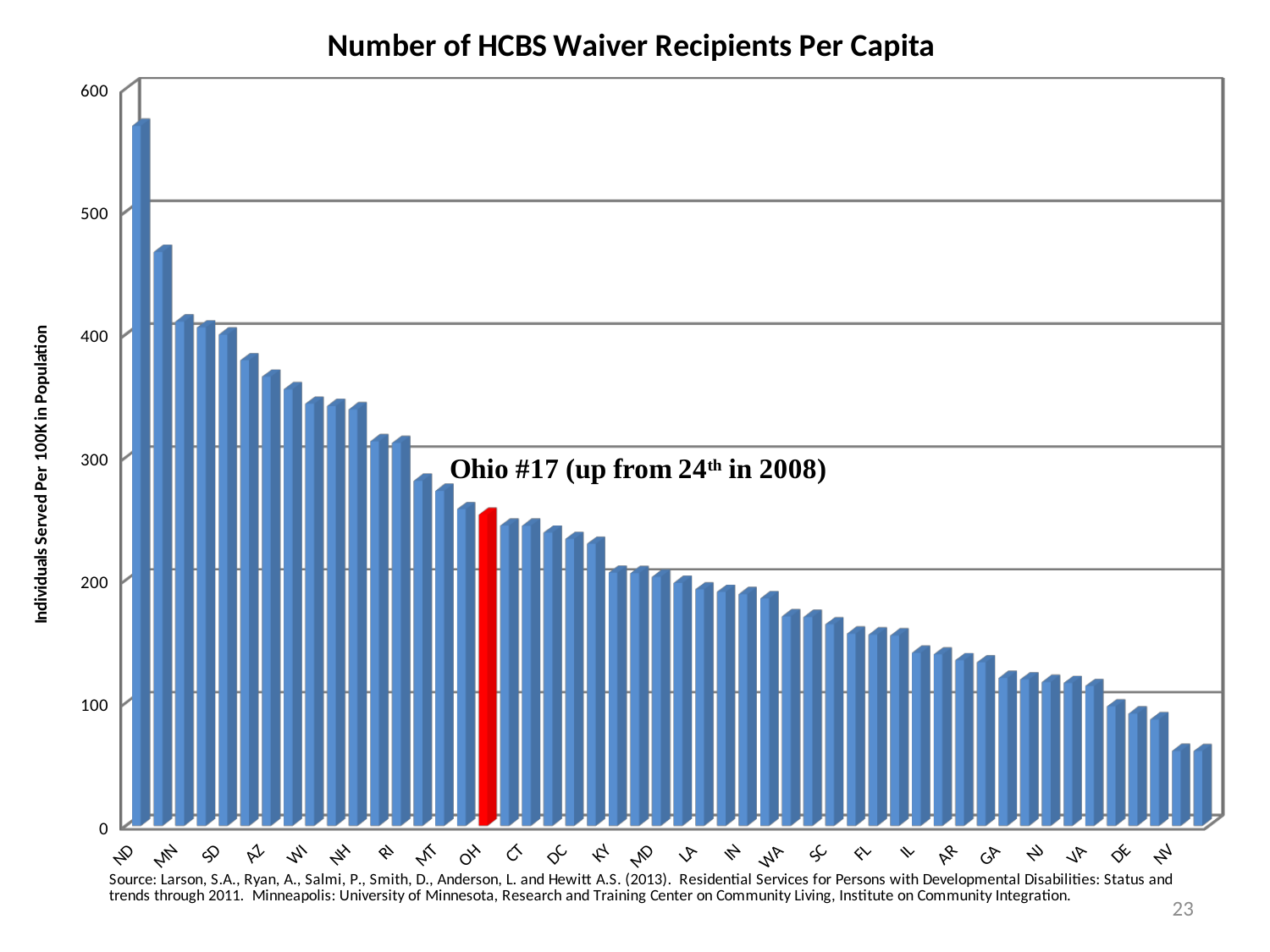
Among the labeled states, which has the lowest number of HCBS waiver recipients per capita? NV Do the values rise or fall moving from left to right along the x axis? fall Is the value for ND greater or less than 500? greater What kind of chart is shown on the slide? bar chart Which state has a higher value, ND or MN? ND Which state has the highest number of HCBS waiver recipients per capita? ND Is the value for OH greater or less than 300? less Which state has a higher value, WI or FL? WI Is the value for WA greater or less than 200? less What rank does the annotation give Ohio in this chart? #17